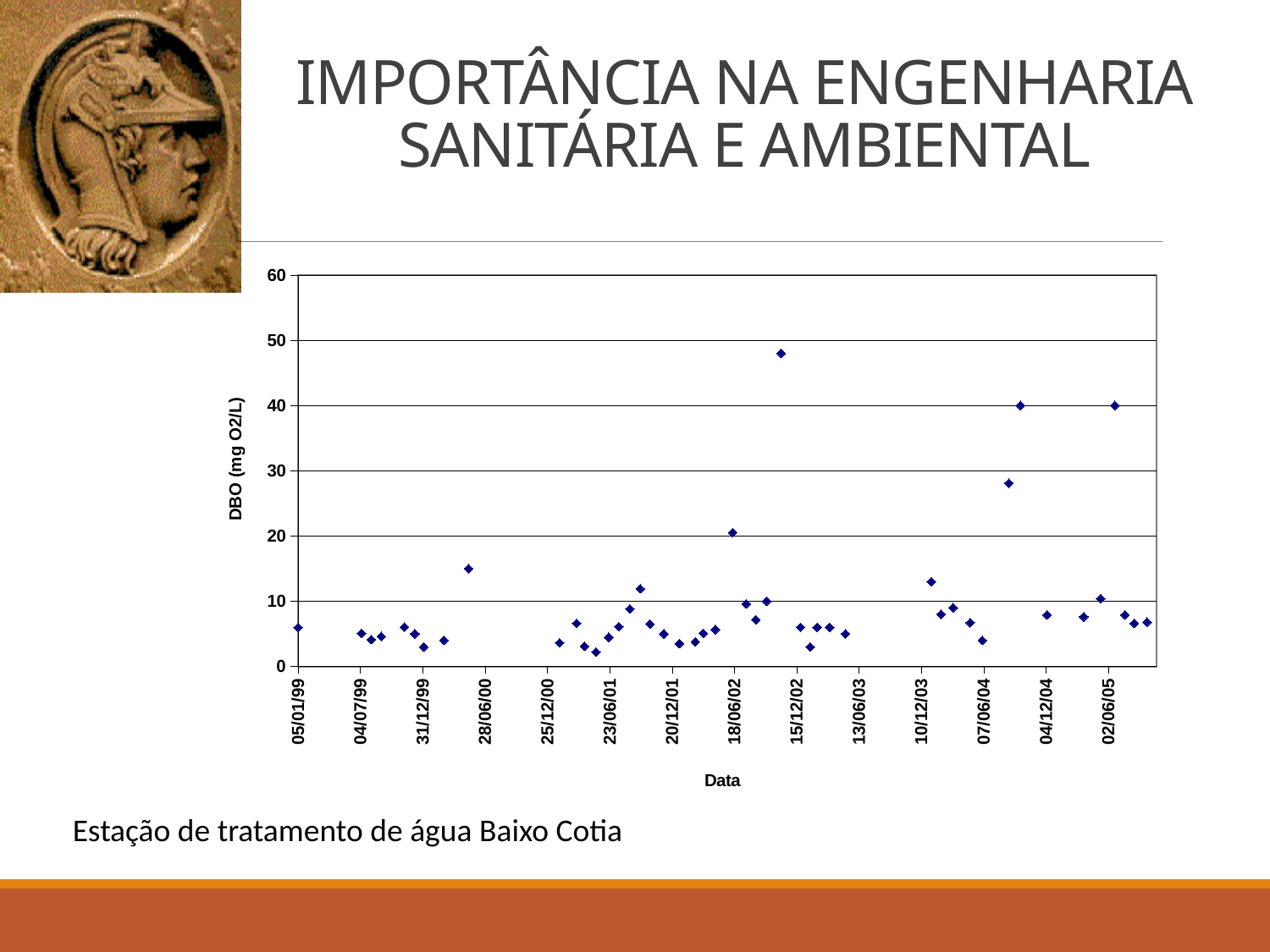
What is the label of the vertical axis of the chart? DBO (mg O2/L) Near which date label does the highest DBO point appear? 15/12/02 What is the label of the horizontal axis of the chart? Data Is the DBO value plotted just before 28/06/00 greater or less than 10? greater What is the maximum value shown on the vertical axis? 60 Is the DBO value plotted at 05/01/99 greater or less than 10? less What kind of chart is shown on the slide? scatter chart How many date labels are shown on the horizontal axis? 14 Is the highest plotted DBO value greater or less than 50? less